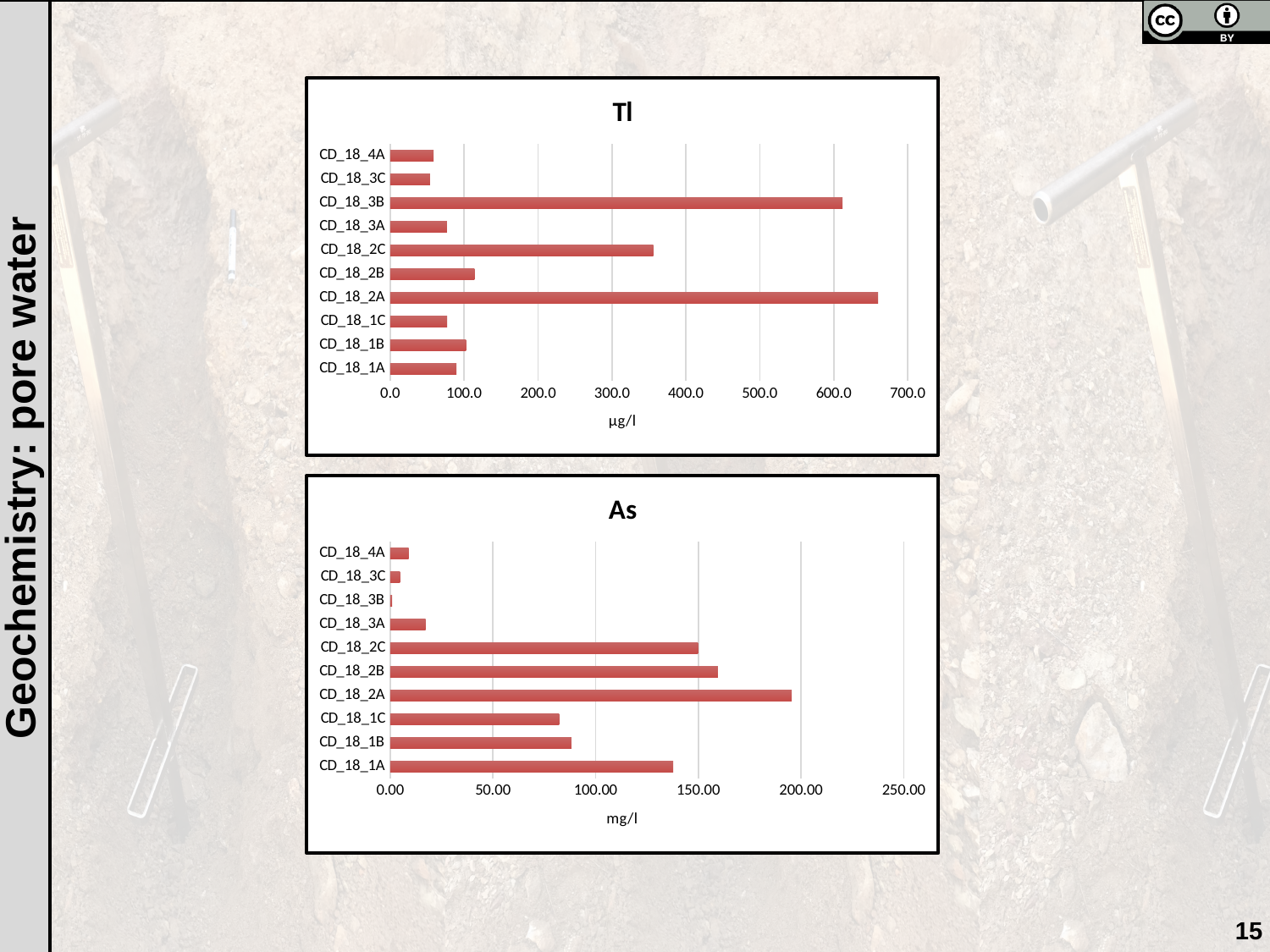
What kind of chart is the Tl chart? bar chart In the Tl chart, is the value for CD_18_2C greater or less than 300.0? greater What unit is shown on the x axis of the As chart? mg/l In the Tl chart, which sample has the highest value? CD_18_2A In the As chart, which sample has the lowest value? CD_18_3B In the As chart, is the value for CD_18_2B greater or less than 150.00? greater In the As chart, is the value for CD_18_1A greater or less than 150.00? less In the As chart, which sample has the highest value? CD_18_2A In the Tl chart, which is larger, the value for CD_18_2C or the value for CD_18_3A? CD_18_2C How many samples are plotted in the Tl chart? 10